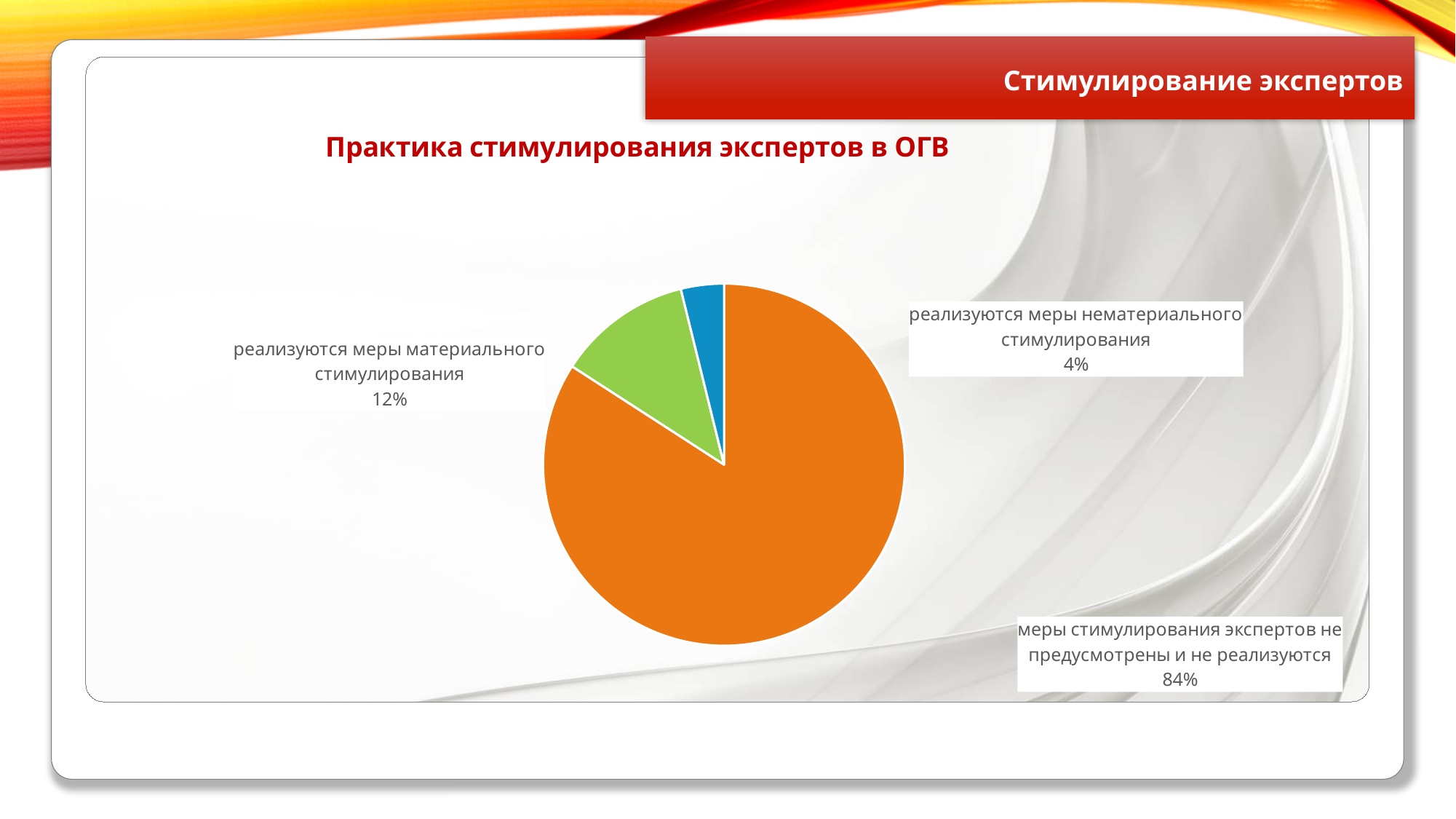
What type of chart is shown on the slide? pie chart What share of the pie is labelled 'реализуются меры нематериального стимулирования'? 4% What share of the pie is labelled 'меры стимулирования экспертов не предусмотрены и не реализуются'? 84% What is the title of the chart? Практика стимулирования экспертов в ОГВ How many slices does the pie chart have? 3 What share of the pie is labelled 'реализуются меры материального стимулирования'? 12% Which category has the smallest slice of the pie? реализуются меры нематериального стимулирования What colour is the slice representing 84%? orange What is the combined share of the two slices where stimulation measures are implemented (material and non-material)? 16% Which category has the largest slice of the pie? меры стимулирования экспертов не предусмотрены и не реализуются What is the difference in percentage points between the 'материального стимулирования' slice and the 'нематериального стимулирования' slice? 8 Which is larger: the share for 'реализуются меры материального стимулирования' or for 'реализуются меры нематериального стимулирования'? реализуются меры материального стимулирования